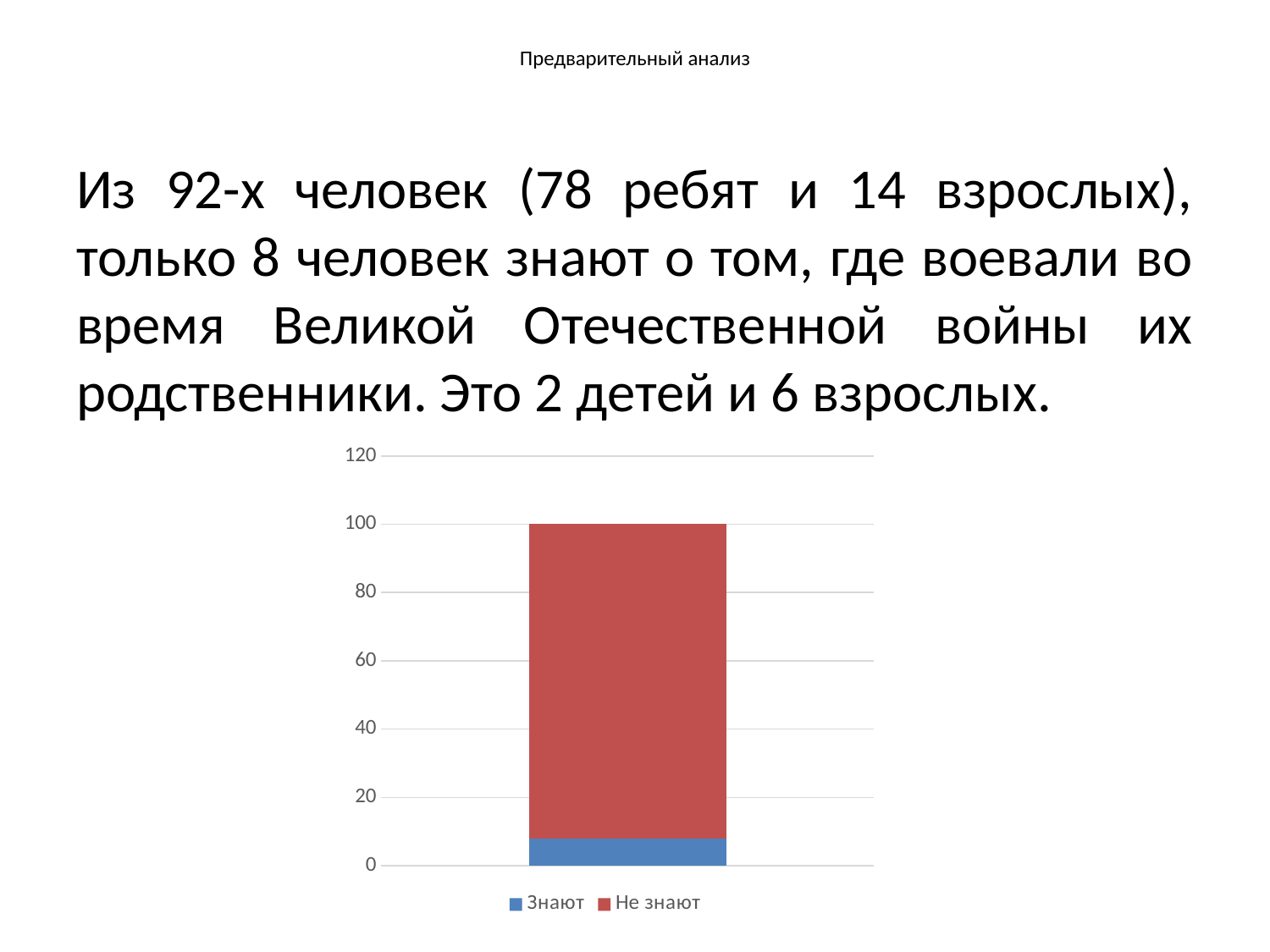
What kind of chart is shown on the slide? stacked bar chart What are the two series named in the chart legend? Знают and Не знают Which series has the largest segment in the stacked bar? Не знают Is the value for "Не знают" in the chart greater or less than 80? greater What is the total height of the stacked bar in the chart? 100 How many series does the chart legend list? 2 Which series has the smallest segment in the stacked bar? Знают What is the highest value shown on the chart's vertical axis? 120 Which series takes up the larger part of the stacked bar, "Знают" or "Не знают"? Не знают Is the value for "Знают" in the chart greater or less than 20? less Which colour represents the series "Не знают" in the chart? red How many bars are plotted in the chart? 1